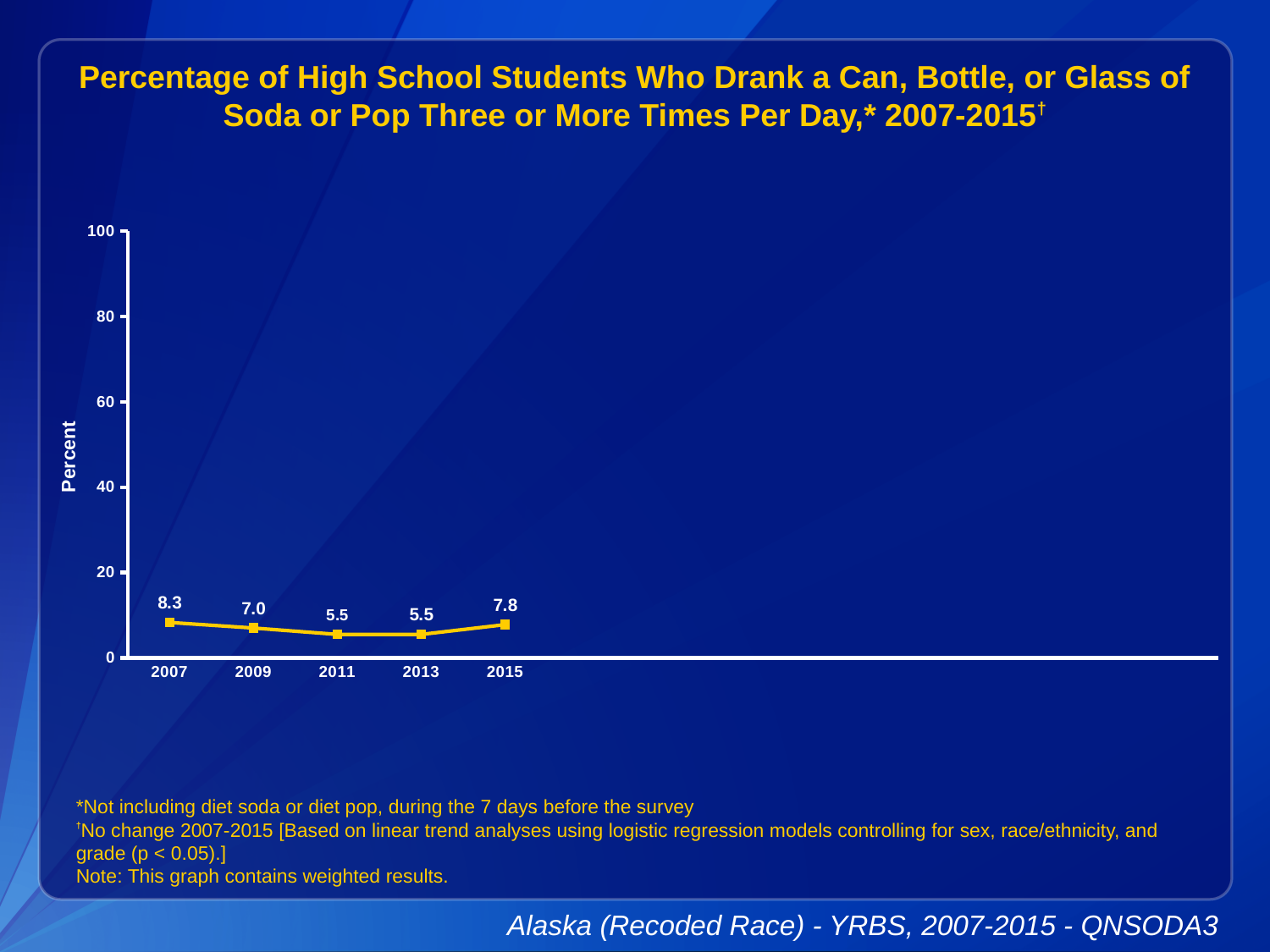
Which is larger, the value for 2007 or the value for 2015? 2007 What kind of chart is shown on the slide? line chart What is the label on the y axis? Percent Do the values rise or fall from 2007 to 2011? fall What is the difference between the values for 2015 and 2009? 0.8 What is the value for 2007? 8.3 What is the value for 2015? 7.8 Which year has the highest value? 2007 How many years are plotted on the chart? 5 Is the value for 2007 greater or less than 20? less What is the value for 2009? 7.0 What is the difference between the values for 2007 and 2011? 2.8